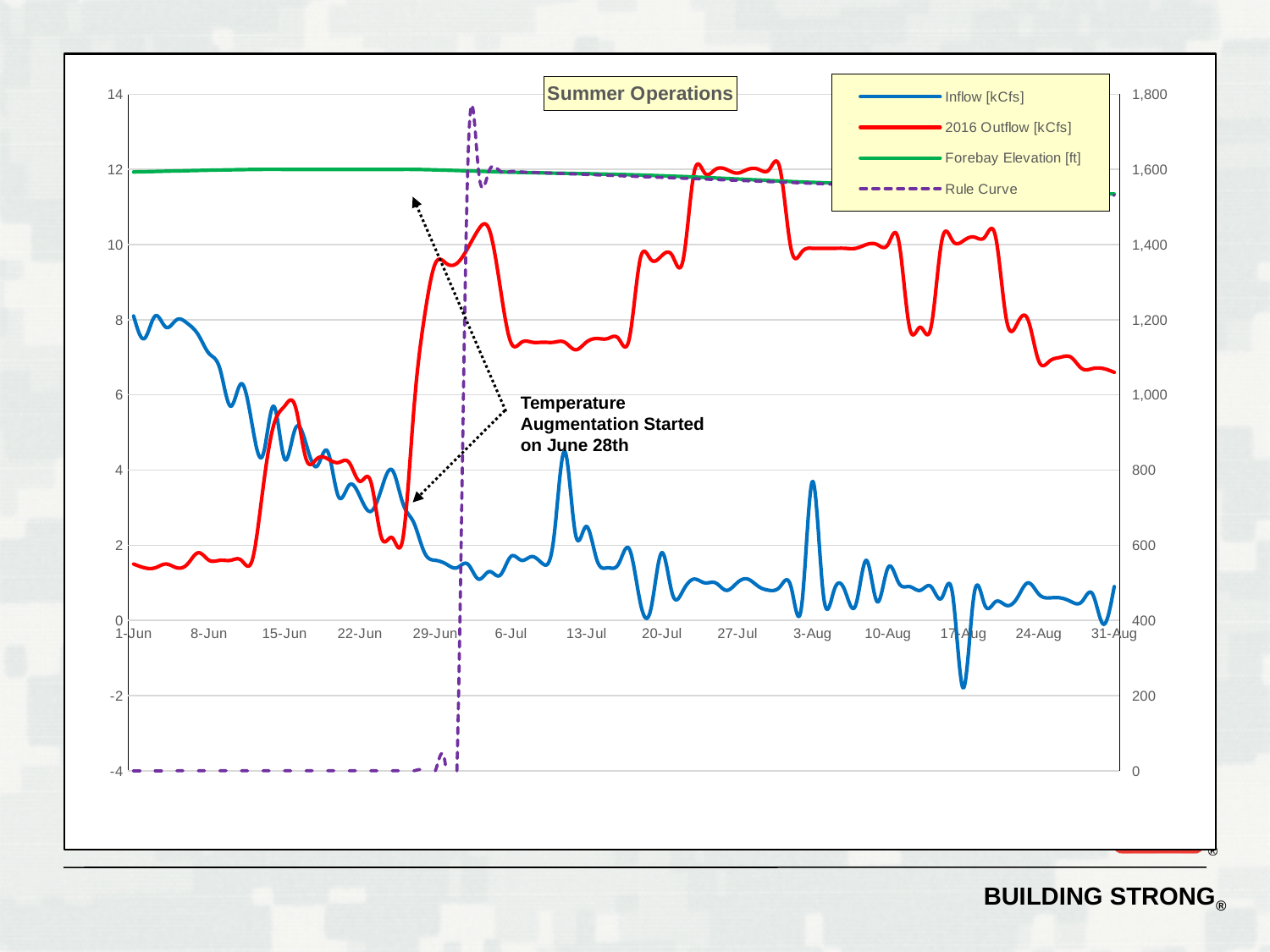
Is the Inflow [kCfs] value on 31-Aug greater or less than 2? less What kind of chart is shown on the slide? Line chart Is the 2016 Outflow [kCfs] value on 1-Jun greater or less than 2? less On 31-Aug, which is larger: Inflow [kCfs] or 2016 Outflow [kCfs]? 2016 Outflow [kCfs] What is the title of the chart? Summer Operations Does the Inflow [kCfs] series generally rise or fall from 1-Jun to 31-Aug? fall How many series does the legend list? 4 Which series is drawn as a dashed line? Rule Curve Is the Inflow [kCfs] value on 1-Jun greater or less than 6? greater How many date labels are shown on the x axis? 14 On 1-Jun, which is larger: Inflow [kCfs] or 2016 Outflow [kCfs]? Inflow [kCfs]